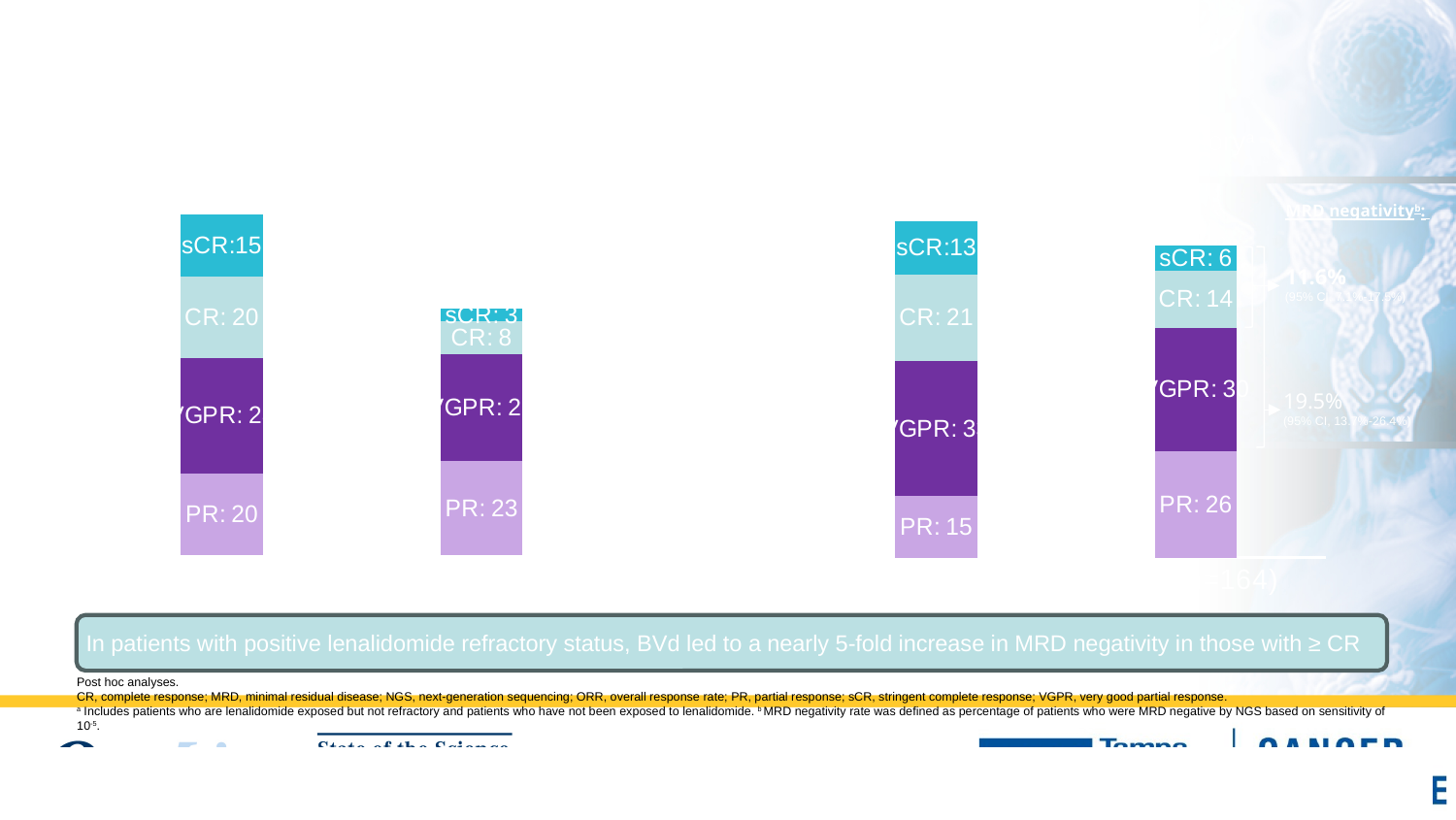
What is the sCR value in the third bar from the left? 13 How many stacked bars are plotted on the chart? 4 What is the PR value in the leftmost bar? 20 What is the sCR value in the leftmost bar? 15 What is the CR value in the third bar from the left? 21 What is the difference between the PR value in the rightmost bar and the PR value in the third bar from the left? 11 Which bar has the highest sCR value? the leftmost bar What is the PR value in the rightmost bar? 26 Which is larger, the CR value in the leftmost bar or the CR value in the rightmost bar? the leftmost bar What kind of chart is shown on the slide? stacked bar chart What is the CR value in the second bar from the left? 8 What is the PR value in the second bar from the left? 23